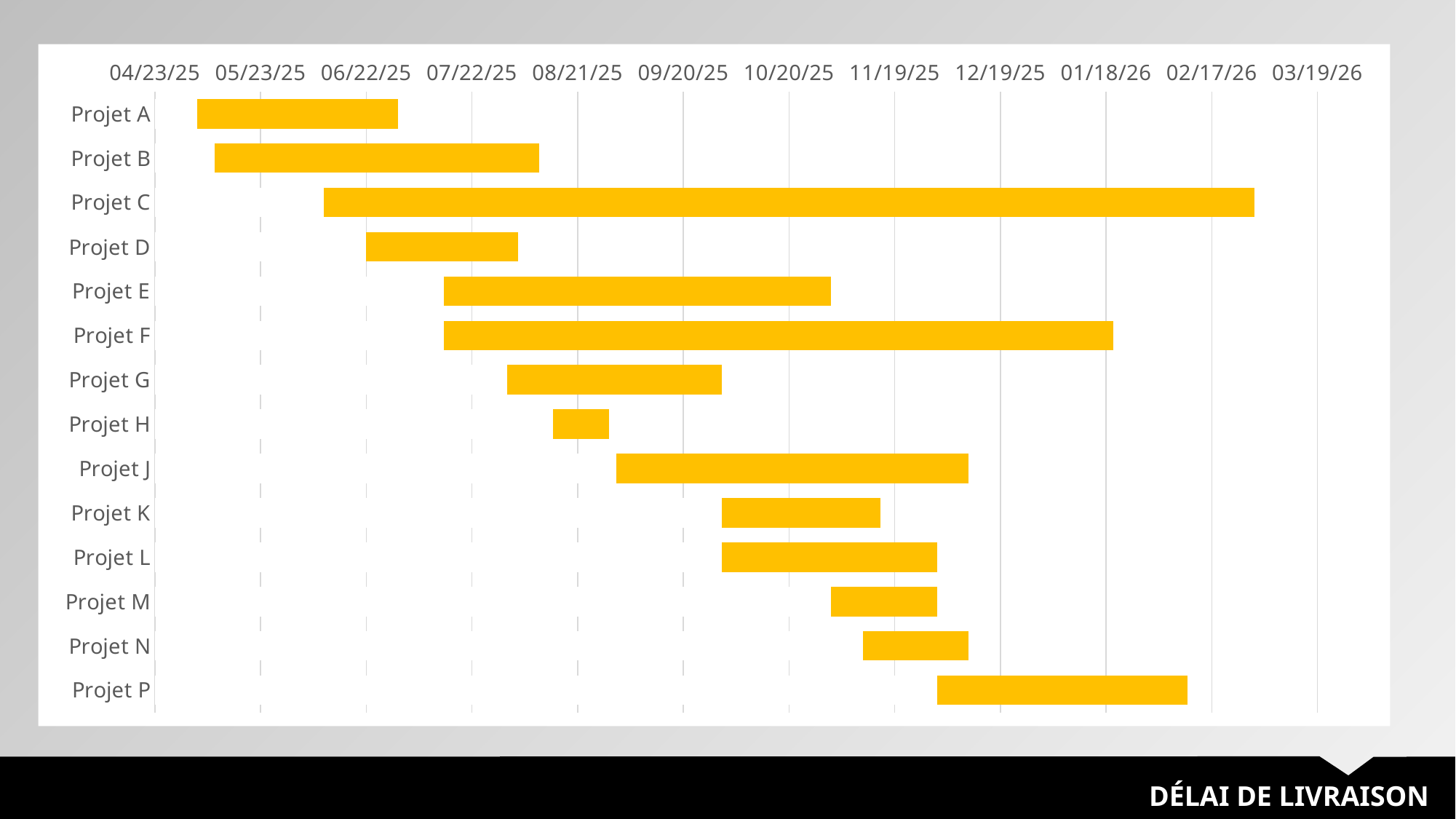
Which bar is longer, Projet F or Projet G? Projet F What is the first date shown on the horizontal axis? 04/23/25 Which project's bar starts earliest on the timeline? Projet A What kind of chart is shown on the slide? Bar chart (Gantt chart) Which project has the shortest bar on the chart? Projet H Does the bar for Projet A end before or after 07/22/25? before Which project's bar starts latest on the timeline? Projet P Which project has the longest bar on the chart? Projet C Does the bar for Projet P start before or after 11/19/25? after How many projects are listed on the chart? 14 Which bar is longer, Projet B or Projet D? Projet B What is the last date shown on the horizontal axis? 03/19/26